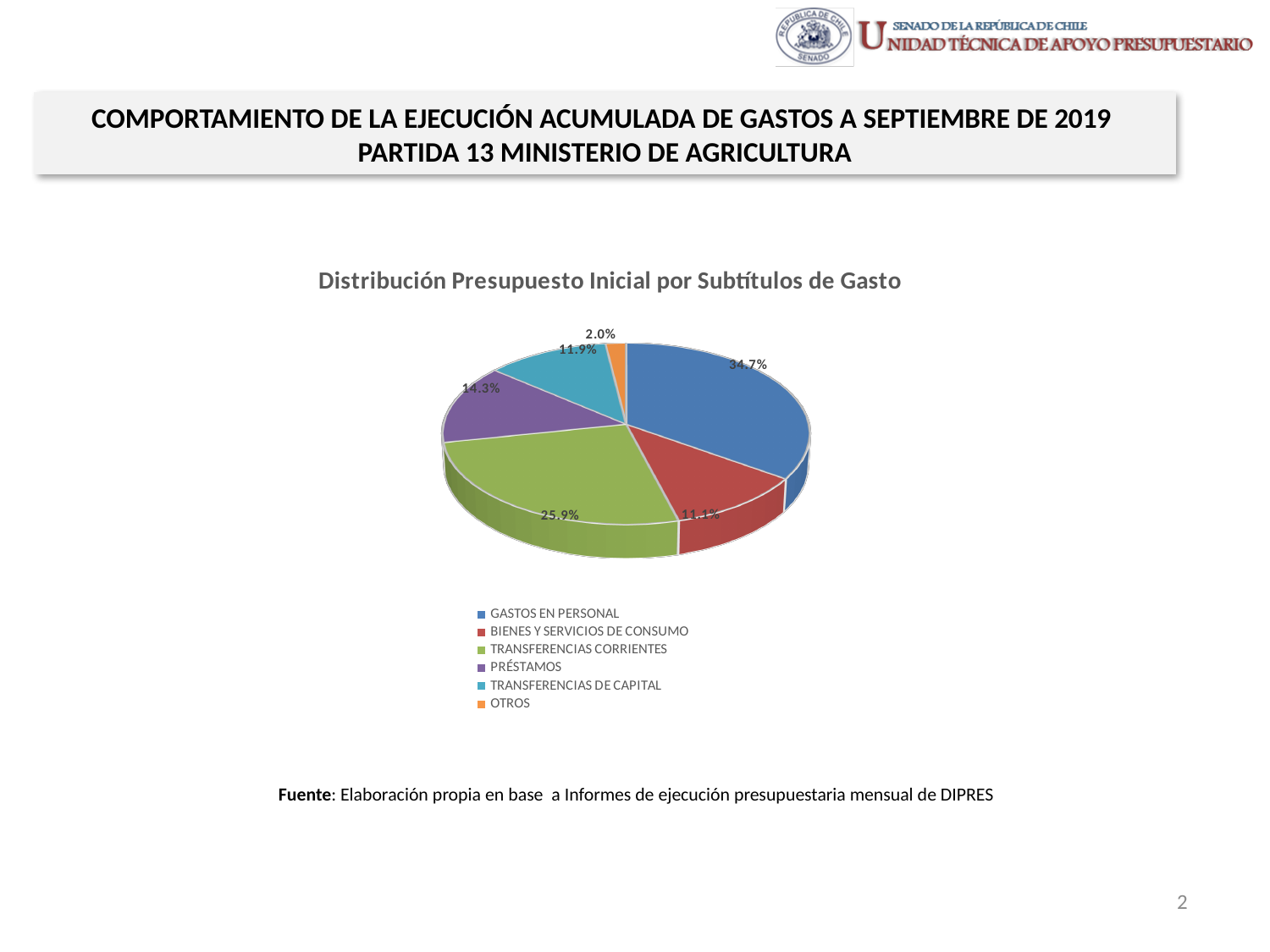
Which category has the largest slice of the pie? GASTOS EN PERSONAL What share of the pie does GASTOS EN PERSONAL represent? 34.7% Which is larger, the share for PRÉSTAMOS or the share for TRANSFERENCIAS DE CAPITAL? PRÉSTAMOS What share of the pie does BIENES Y SERVICIOS DE CONSUMO represent? 11.1% How many categories does the pie chart show? 6 Which category has the smallest slice of the pie? OTROS What share of the pie does OTROS represent? 2.0% What kind of chart is shown on the slide? Pie chart What is the difference in percentage points between GASTOS EN PERSONAL and TRANSFERENCIAS CORRIENTES? 8.8 percentage points What is the title of the chart? Distribución Presupuesto Inicial por Subtítulos de Gasto